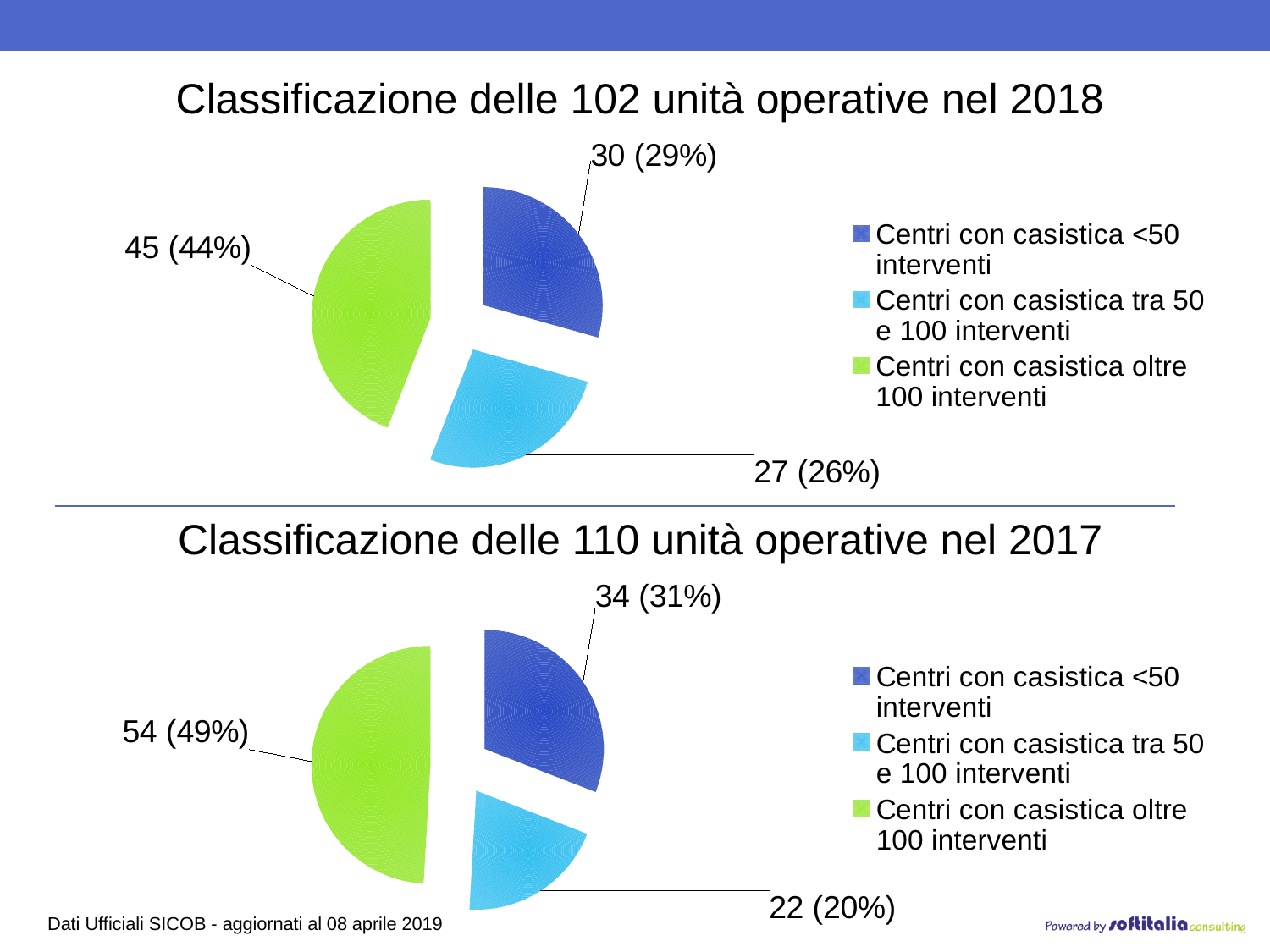
In the chart 'Classificazione delle 102 unità operative nel 2018', what is the value for 'Centri con casistica <50 interventi'? 30 (29%) How many categories does the top chart show? 3 In the chart 'Classificazione delle 110 unità operative nel 2017', which is larger: 'Centri con casistica <50 interventi' or 'Centri con casistica tra 50 e 100 interventi'? Centri con casistica <50 interventi In the chart 'Classificazione delle 110 unità operative nel 2017', what is the value for 'Centri con casistica tra 50 e 100 interventi'? 22 (20%) In the chart 'Classificazione delle 102 unità operative nel 2018', what share of the pie is 'Centri con casistica oltre 100 interventi'? 44% In the chart 'Classificazione delle 102 unità operative nel 2018', what is the difference between the number of centres with over 100 interventions and those with fewer than 50? 15 In the chart 'Classificazione delle 102 unità operative nel 2018', what is the value for 'Centri con casistica tra 50 e 100 interventi'? 27 (26%) What kind of chart is the bottom chart on the slide? Pie chart In the chart 'Classificazione delle 110 unità operative nel 2017', what is the value for 'Centri con casistica oltre 100 interventi'? 54 (49%) In the chart 'Classificazione delle 110 unità operative nel 2017', what share of the pie is 'Centri con casistica <50 interventi'? 31% In the chart 'Classificazione delle 102 unità operative nel 2018', which category has the largest slice? Centri con casistica oltre 100 interventi In the chart 'Classificazione delle 110 unità operative nel 2017', which category has the smallest slice? Centri con casistica tra 50 e 100 interventi